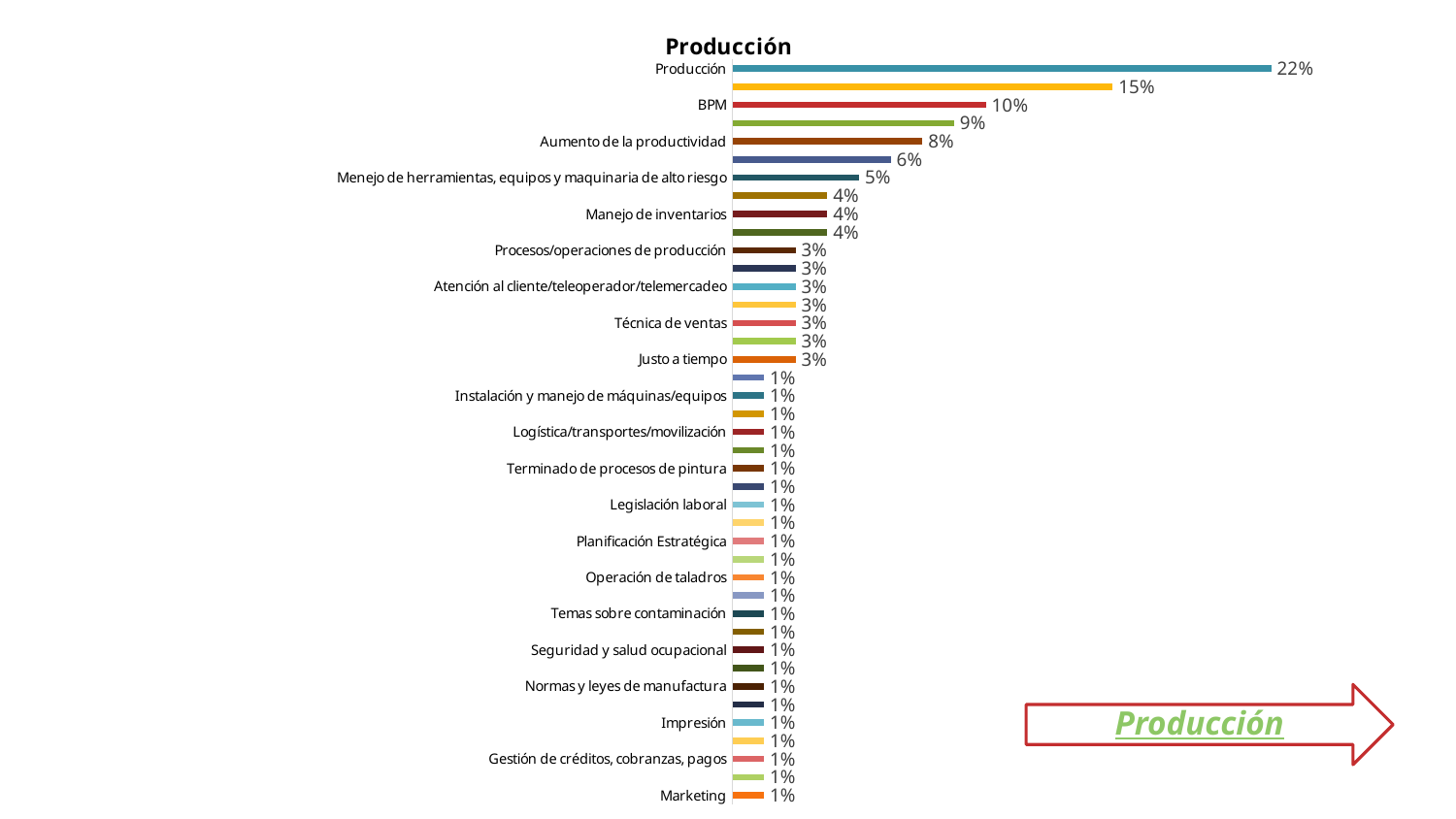
What is the value for BPM? 10% Which is larger, the value for BPM or the value for Aumento de la productividad? BPM What is the title of the chart? Producción What is the difference between the values for Producción and BPM? 12 percentage points What is the value for Justo a tiempo? 3% What kind of chart is shown on the slide? Bar chart What is the value for Manejo de inventarios? 4% What is the value for Menejo de herramientas, equipos y maquinaria de alto riesgo? 5% What is the value for Producción? 22% What is the value for Aumento de la productividad? 8% Which category has the highest value? Producción What is the value for Marketing? 1%